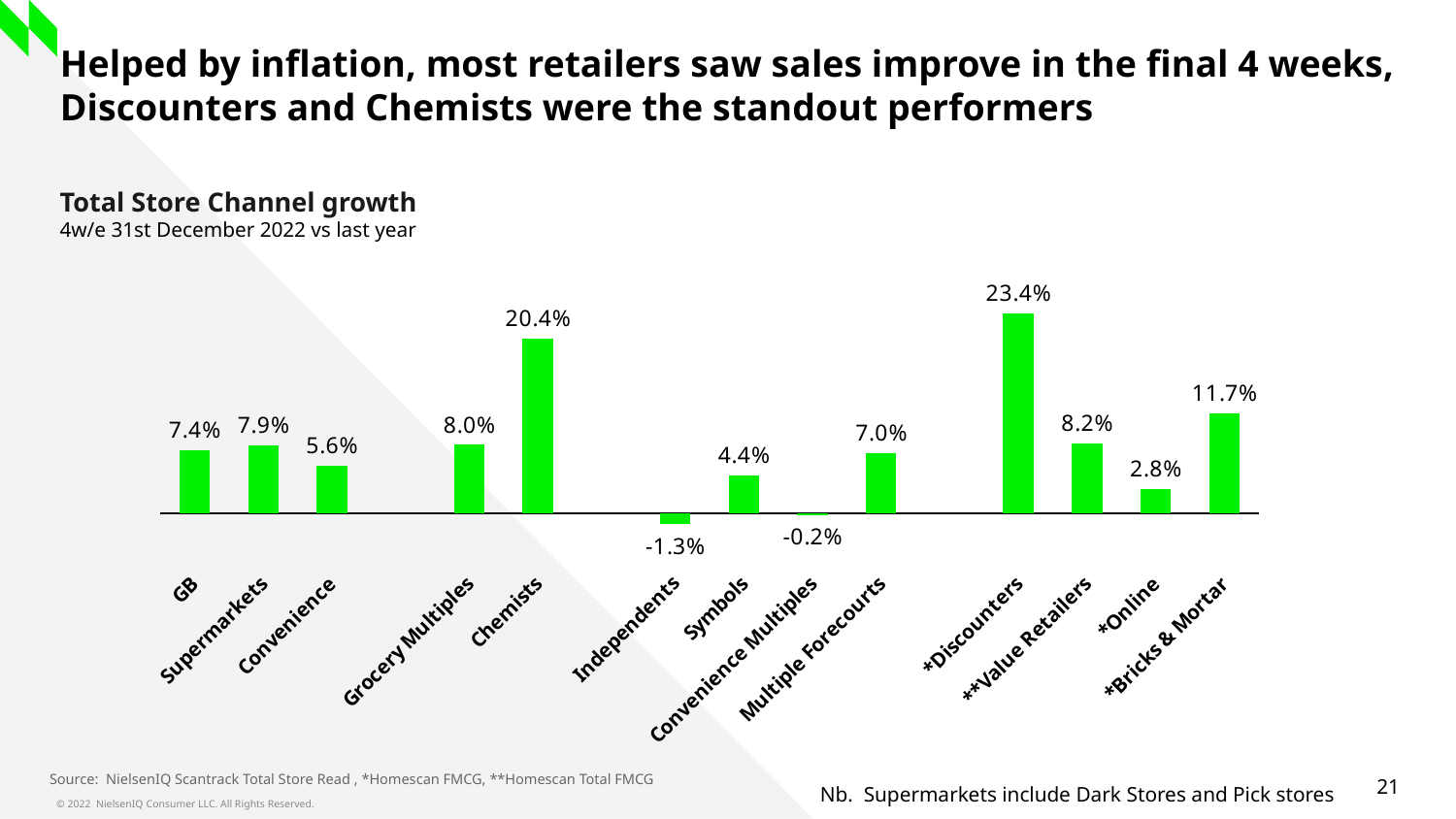
What is the title of the chart? Total Store Channel growth What is the difference between the growth for *Bricks & Mortar and *Online? 8.9% How many channels are shown in the chart? 14 What kind of chart is shown on the slide? Bar chart Which channel has the lowest growth? Independents What is the difference between the growth for *Discounters and Chemists? 3.0% Which has the larger growth, Supermarkets or Convenience? Supermarkets What is the growth value for Chemists? 20.4% What is the growth value for Independents? -1.3% Which channel has the highest growth? *Discounters What is the growth value for Multiple Forecourts? 7.0% What is the growth value for *Online? 2.8%